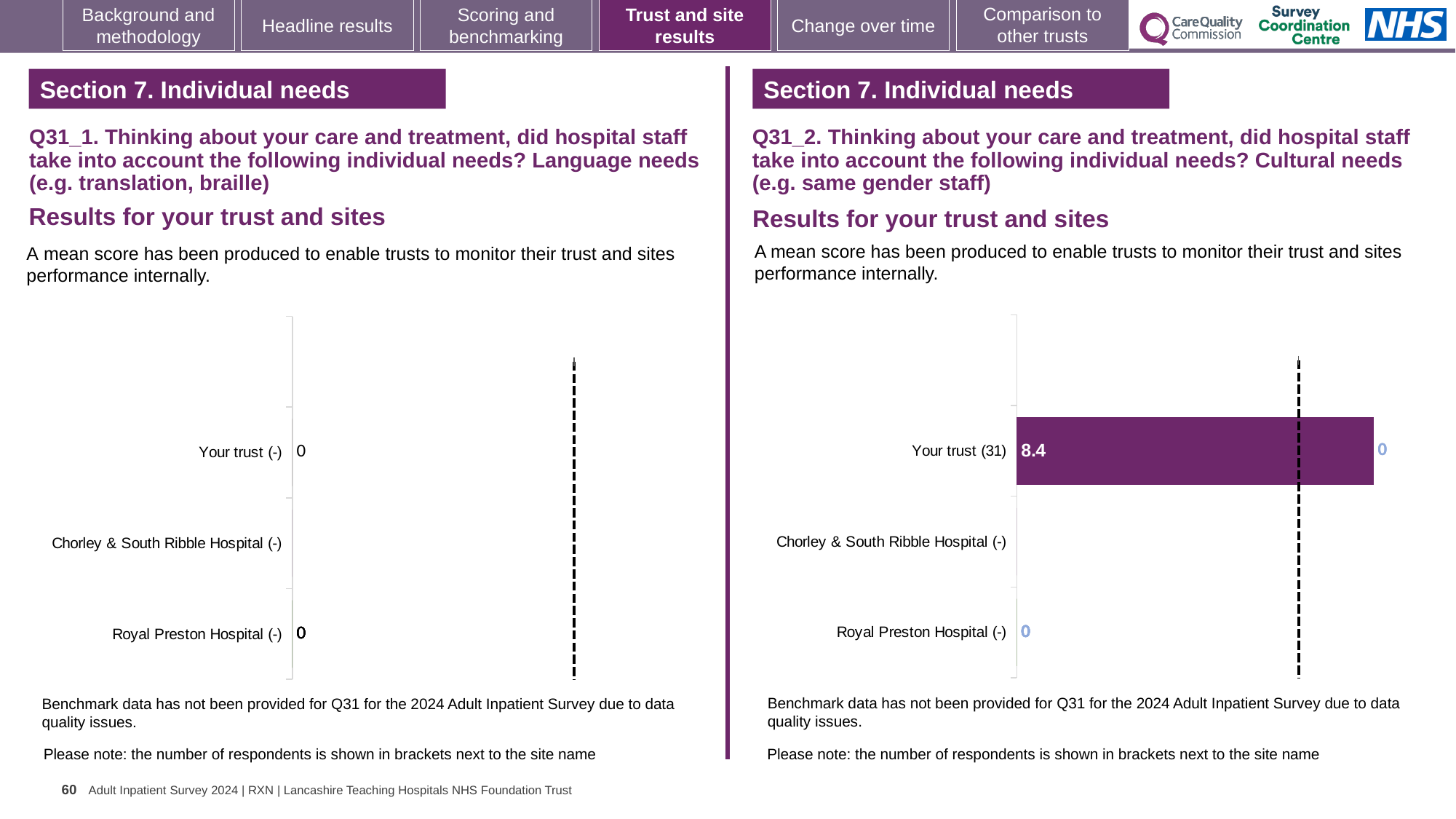
What type of chart is used on the Q31_2 chart (right)? Bar chart How many categories are listed on the Q31_2 chart (right)? 3 On the Q31_2 chart (right), is the value for Your trust (31) larger or smaller than the value for Royal Preston Hospital (-)? Larger How many categories are listed on the Q31_1 chart (left)? 3 On the Q31_2 chart (right), which category has the highest mean score? Your trust (31) On the Q31_1 chart (left), what value is shown for Royal Preston Hospital (-)? 0 On the Q31_2 chart (right), what is the mean score for Your trust (31)? 8.4 On the Q31_1 chart (left), what value is shown for Your trust (-)? 0 On the Q31_2 chart (right), how many respondents are shown in brackets for Your trust? 31 On the Q31_2 chart (right), what is the difference between the value for Your trust (31) and the value for Royal Preston Hospital (-)? 8.4 On the Q31_2 chart (right), what value is shown for Royal Preston Hospital (-)? 0 Which category appears at the bottom of the Q31_1 chart (left)? Royal Preston Hospital (-)